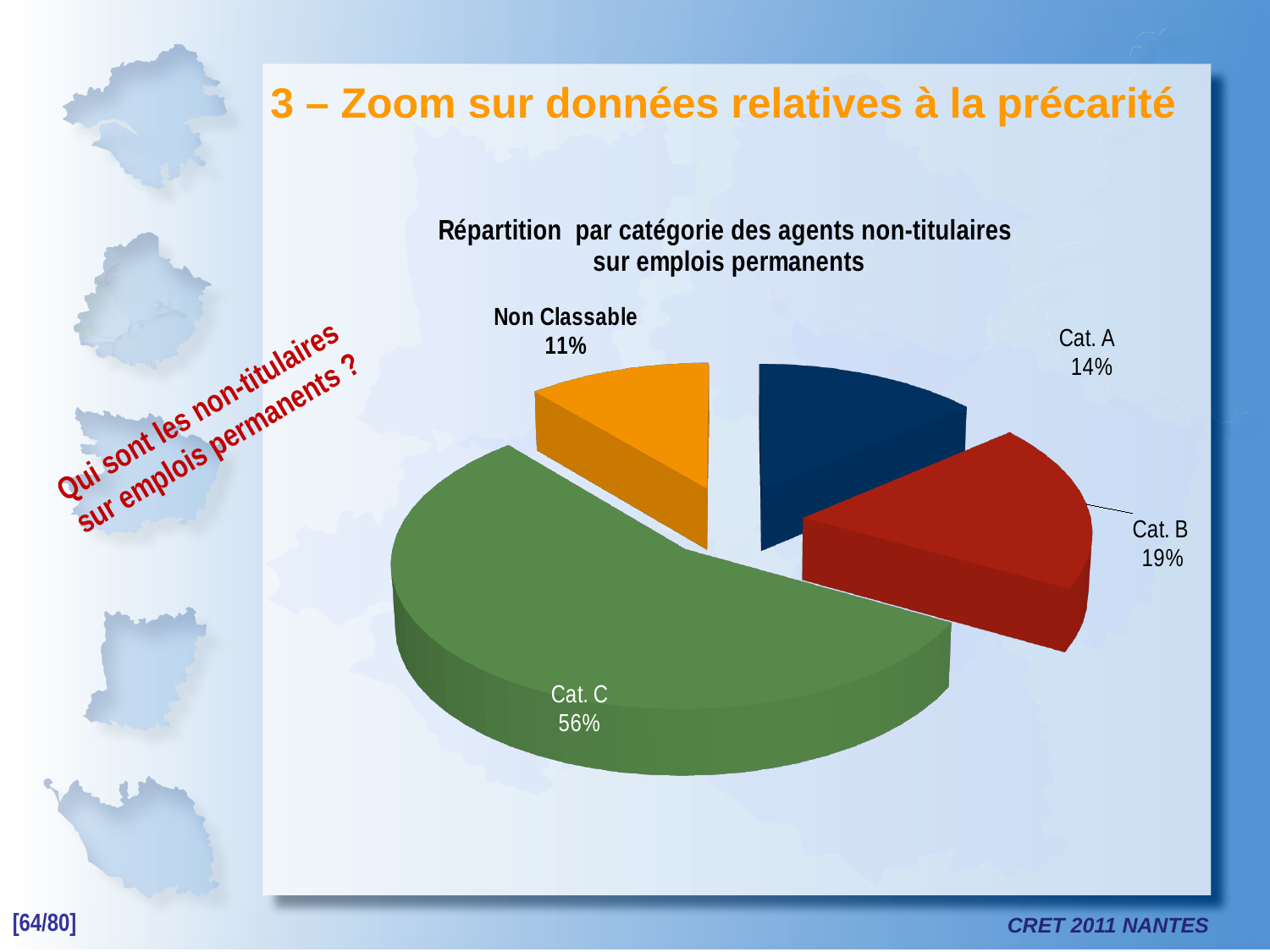
Which is larger, the share for Cat. A or the share for Cat. B? Cat. B What is the share for Cat. C? 56% What is the difference in percentage points between Cat. C and Cat. B? 37 What is the share for Cat. B? 19% What is the difference in percentage points between Cat. B and Cat. A? 5 What is the title of the chart? Répartition par catégorie des agents non-titulaires sur emplois permanents What is the share for Cat. A? 14% Which category has the smallest share of the pie? Non Classable What is the share for Non Classable? 11% Which category has the largest share of the pie? Cat. C What type of chart is shown on the slide? Pie chart How many categories are shown in the pie chart? 4